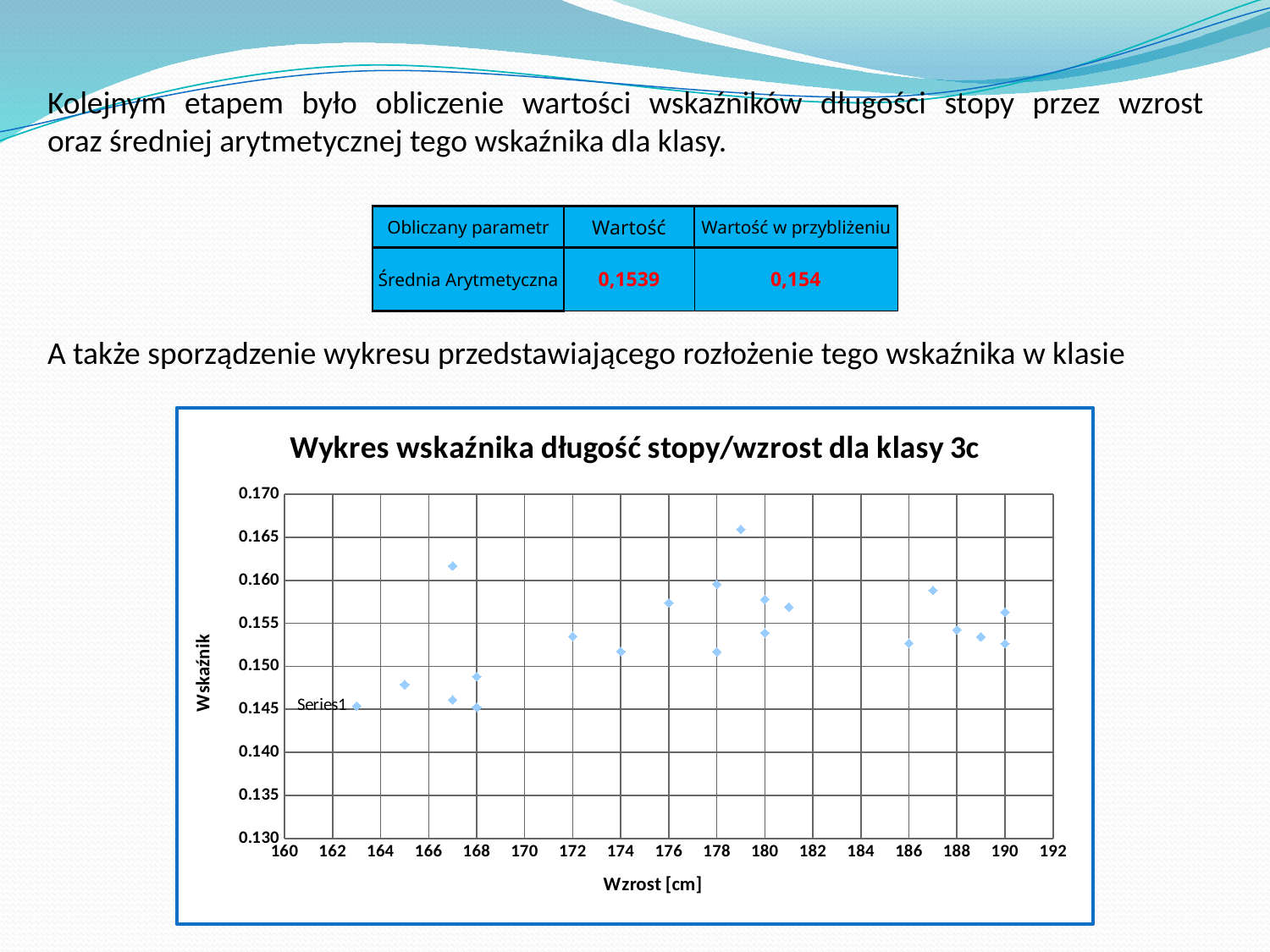
What is the label of the x axis of the chart? Wzrost [cm] Do the indicator values generally rise or fall as height increases along the x axis? rise What is the highest value shown on the y axis of the chart? 0.170 What is the title of the chart? Wykres wskaźnika długość stopy/wzrost dla klasy 3c What kind of chart is shown on the slide? scatter chart Which is larger: the indicator value at height 176 cm or at height 174 cm? 176 cm Is the indicator value for the point at height 174 cm greater or less than 0.155? less Is the highest indicator value for the points at height 167 cm greater or less than 0.160? greater Is the indicator value for the point at height 163 cm greater or less than 0.150? less